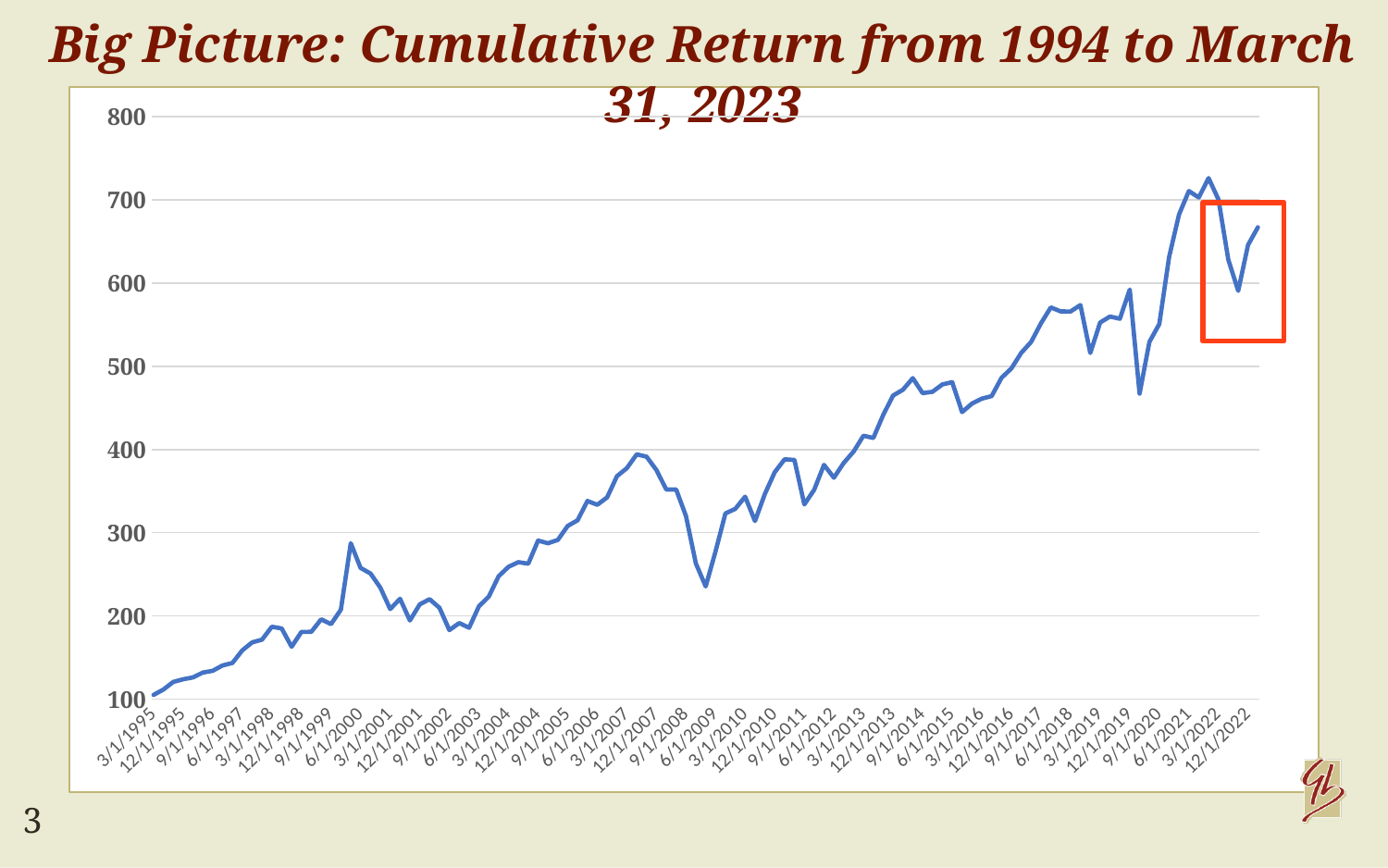
What is the title of the chart? Big Picture: Cumulative Return from 1994 to March 31, 2023 What kind of chart is shown on the slide? line chart Is the value at 12/1/2022 greater or less than 700? less Is the value at 6/1/2000 greater or less than 300? less Is the value at 12/1/2022 greater or less than 600? greater Overall, does the line rise or fall from left to right along the x axis? rise Which x-axis label corresponds to the lowest point on the line? 3/1/1995 Which is larger, the value at 3/1/1995 or the value at 12/1/2022? 12/1/2022 What is the highest value shown on the y axis? 800